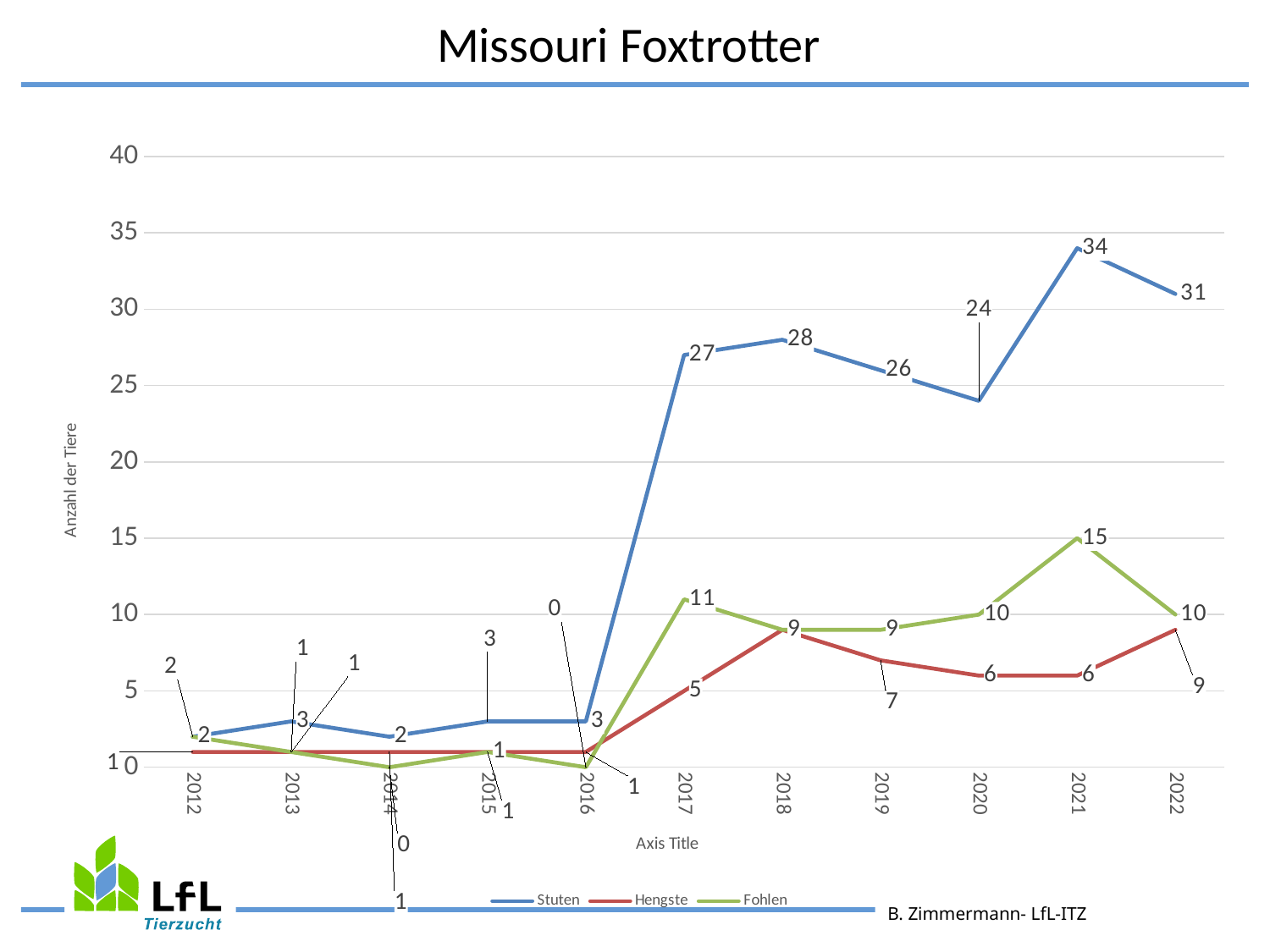
In which year is the Stuten series highest? 2021 In which year is the Fohlen series highest? 2021 What is the value for Stuten in 2021? 34 Which is larger in 2020, Stuten or Fohlen? Stuten How many years are shown on the x axis? 11 How many series does the legend list? 3 What is the title of the y axis? Anzahl der Tiere What is the value for Stuten in 2022? 31 What is the difference between the Stuten values for 2021 and 2022? 3 What kind of chart is shown on the slide? line chart What is the value for Fohlen in 2021? 15 What is the value for Hengste in 2018? 9